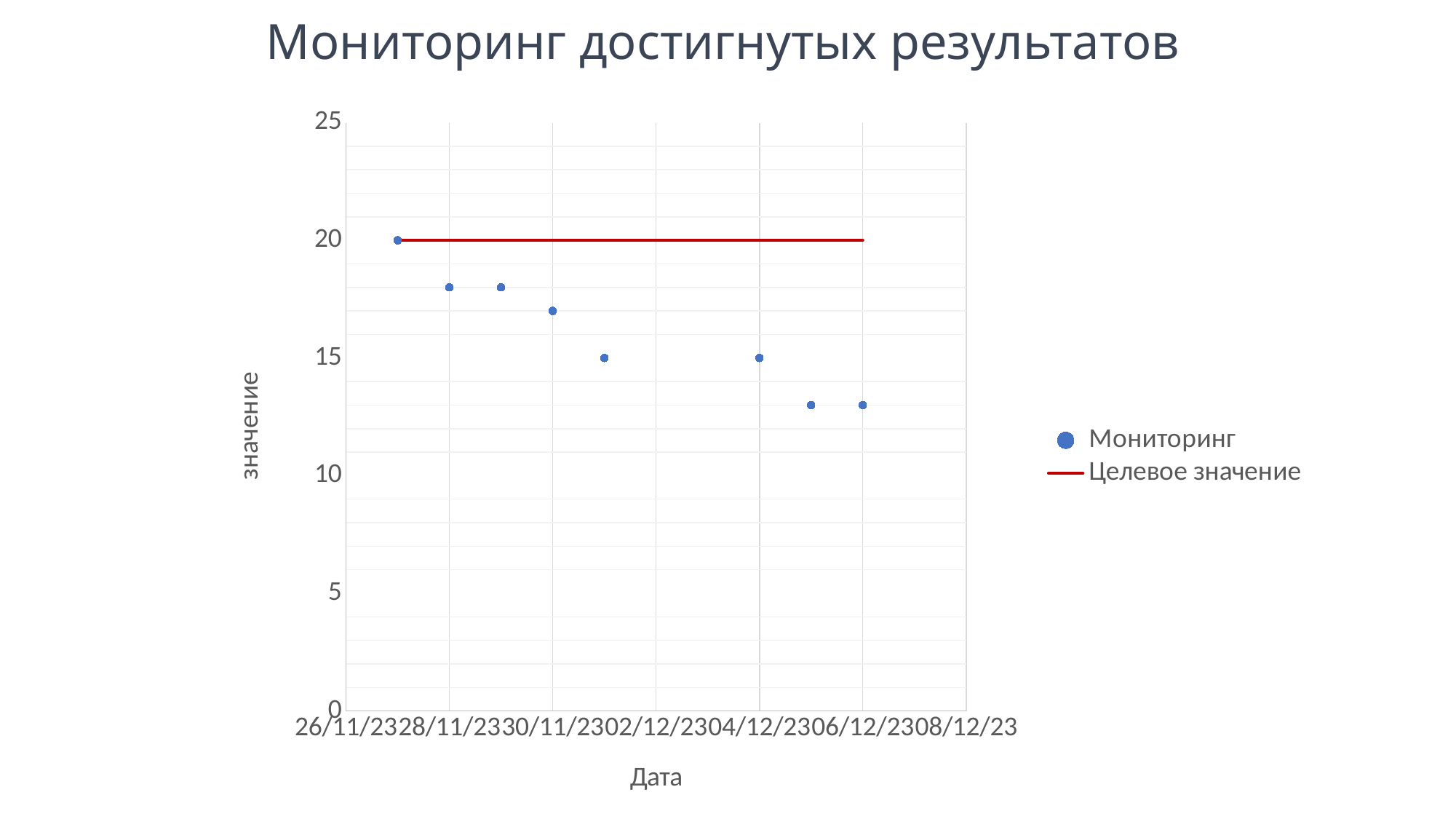
Is the Мониторинг value on 30/11/23 greater or less than 15? greater Is the Мониторинг value on 28/11/23 greater or less than 15? greater Do the Мониторинг values generally rise or fall along the x axis? fall What kind of chart is shown on the slide? scatter chart How many data points are plotted for the Мониторинг series? 8 How many series does the legend list? 2 Which is larger: the Мониторинг value on 28/11/23 or on 06/12/23? 28/11/23 Is the Целевое значение line greater or less than 15? greater What is the title of the chart? Мониторинг достигнутых результатов What is the label of the x axis? Дата